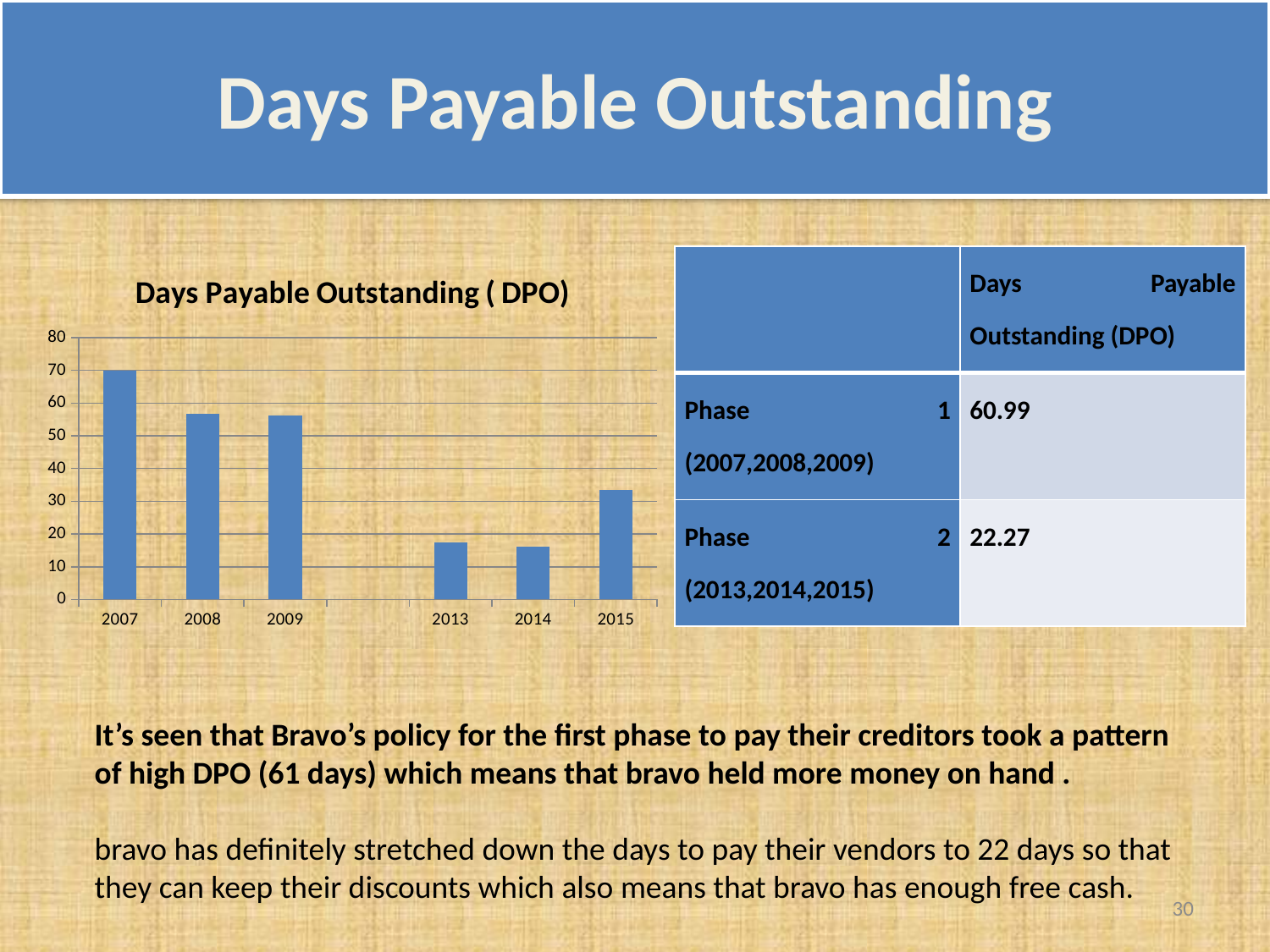
What is the title of the chart? Days Payable Outstanding ( DPO) Is the value for 2008 greater or less than 50? greater How many years are shown on the x axis of the chart? 6 Is the value for 2007 greater or less than 60? greater What kind of chart is shown on the slide? bar chart Which year has the highest Days Payable Outstanding in the chart? 2007 Which is larger, the value for 2007 or the value for 2015? 2007 Is the value for 2014 greater or less than 20? less Do the values rise or fall from 2007 to 2009? fall Which is larger, the value for 2008 or the value for 2013? 2008